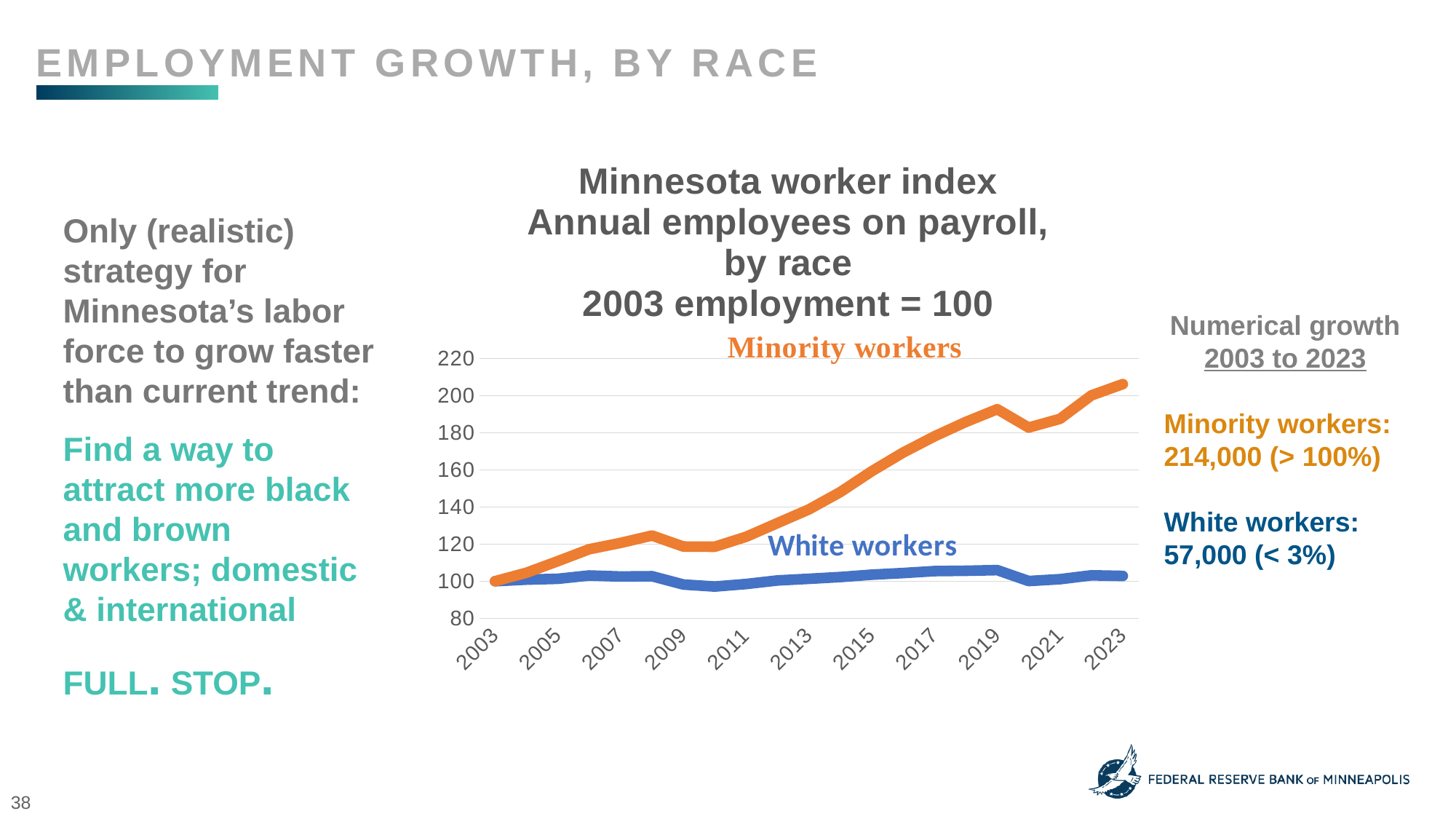
Does the Minority workers line generally rise or fall from 2003 to 2023? rise Is the White workers index value in 2023 greater or less than 120? less What colour is the line for Minority workers? orange Is the Minority workers index value in 2023 greater or less than 200? greater What is the index value for both series in 2003? 100 How many series are plotted on the chart? 2 Is the Minority workers index value in 2019 greater or less than 180? greater Which series has the higher index value in 2023? Minority workers What are the two series labelled on the chart? Minority workers and White workers What kind of chart is shown on the slide? line chart How many year labels are shown on the x axis? 11